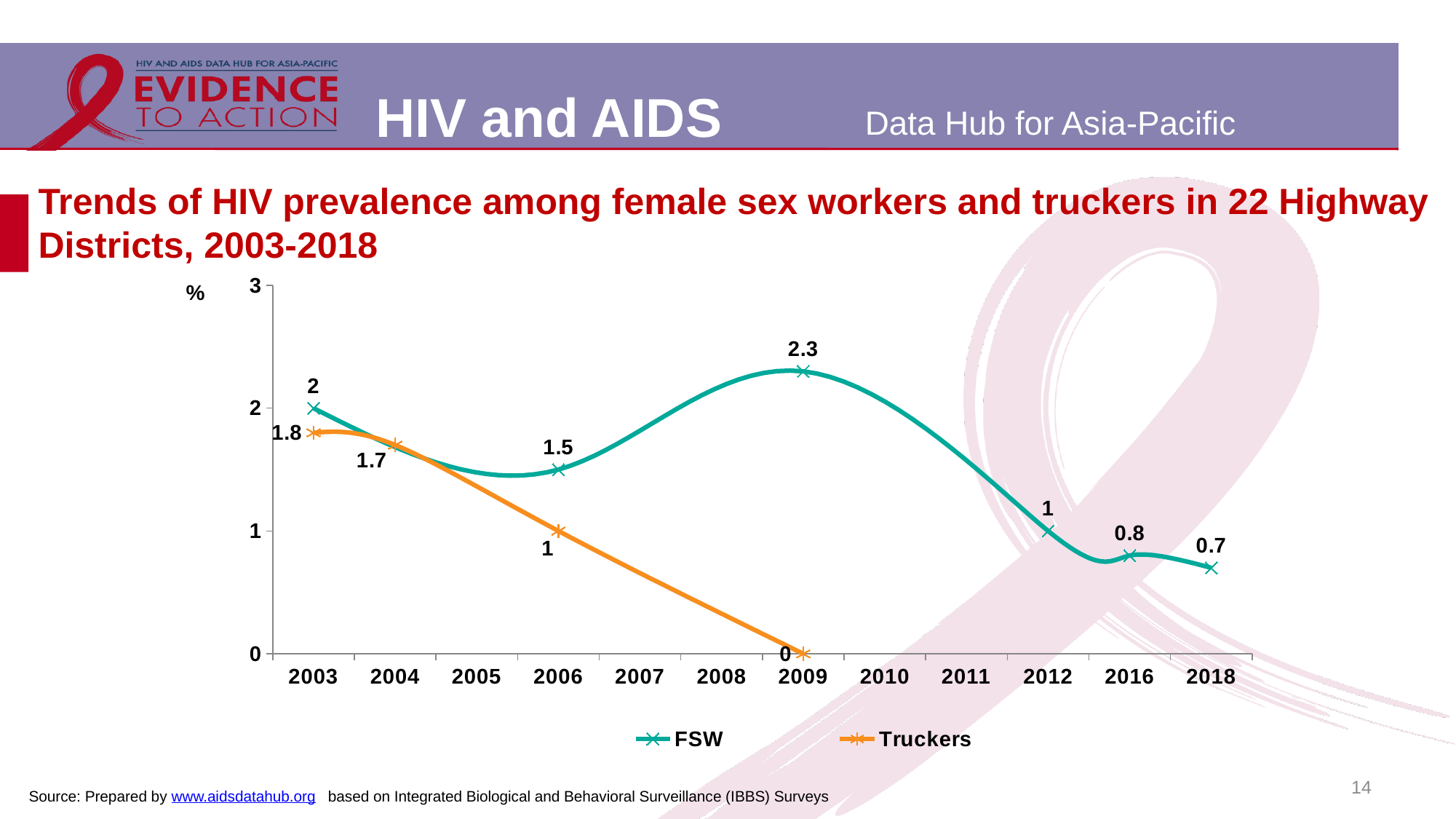
What type of chart is shown on the slide? Line chart In 2006, which series has the higher value, FSW or Truckers? FSW Does the Truckers series rise or fall from 2003 to 2009? Fall How many series does the legend list? 2 What colour is the Truckers line? Orange What is the difference between the FSW value in 2009 and the FSW value in 2012? 1.3 In which year is the FSW HIV prevalence highest? 2009 How many year labels are shown on the x axis? 12 What is the HIV prevalence among FSW in 2009? 2.3 What is the HIV prevalence among Truckers in 2004? 1.7 What is the HIV prevalence among FSW in 2018? 0.7 In which year is the Truckers HIV prevalence lowest? 2009